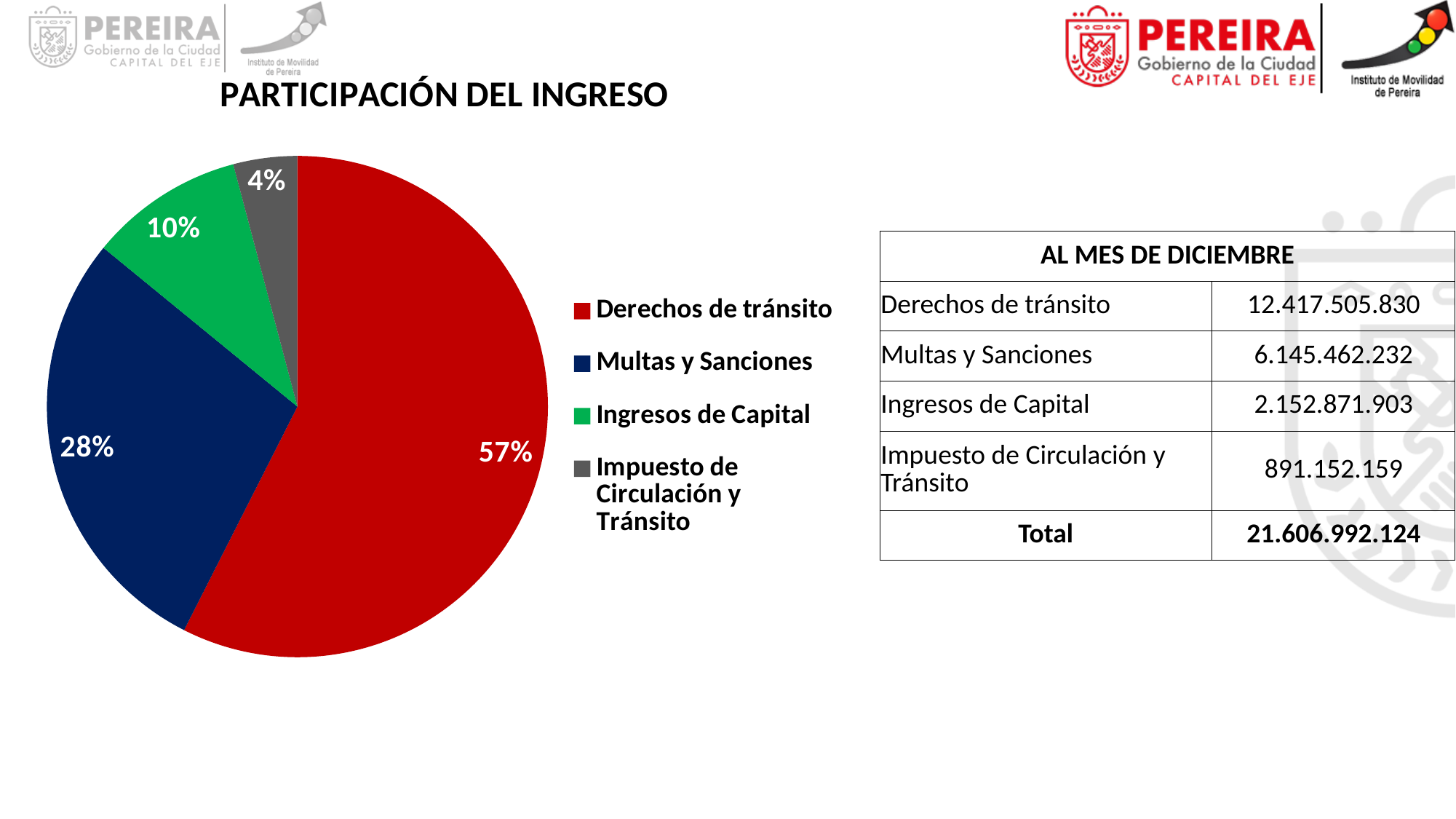
What share of the pie does Derechos de tránsito represent? 57% How many slices does the pie chart have? 4 What share of the pie does Impuesto de Circulación y Tránsito represent? 4% What colour is the Ingresos de Capital slice in the pie chart? Green What share of the pie does Multas y Sanciones represent? 28% Which category has the smallest slice of the pie? Impuesto de Circulación y Tránsito Which category has the largest slice of the pie? Derechos de tránsito What kind of chart is shown on the slide? Pie chart What is the title of the chart? PARTICIPACIÓN DEL INGRESO What is the difference in percentage points between the Derechos de tránsito slice and the Multas y Sanciones slice? 29 Which slice is larger, Ingresos de Capital or Multas y Sanciones? Multas y Sanciones